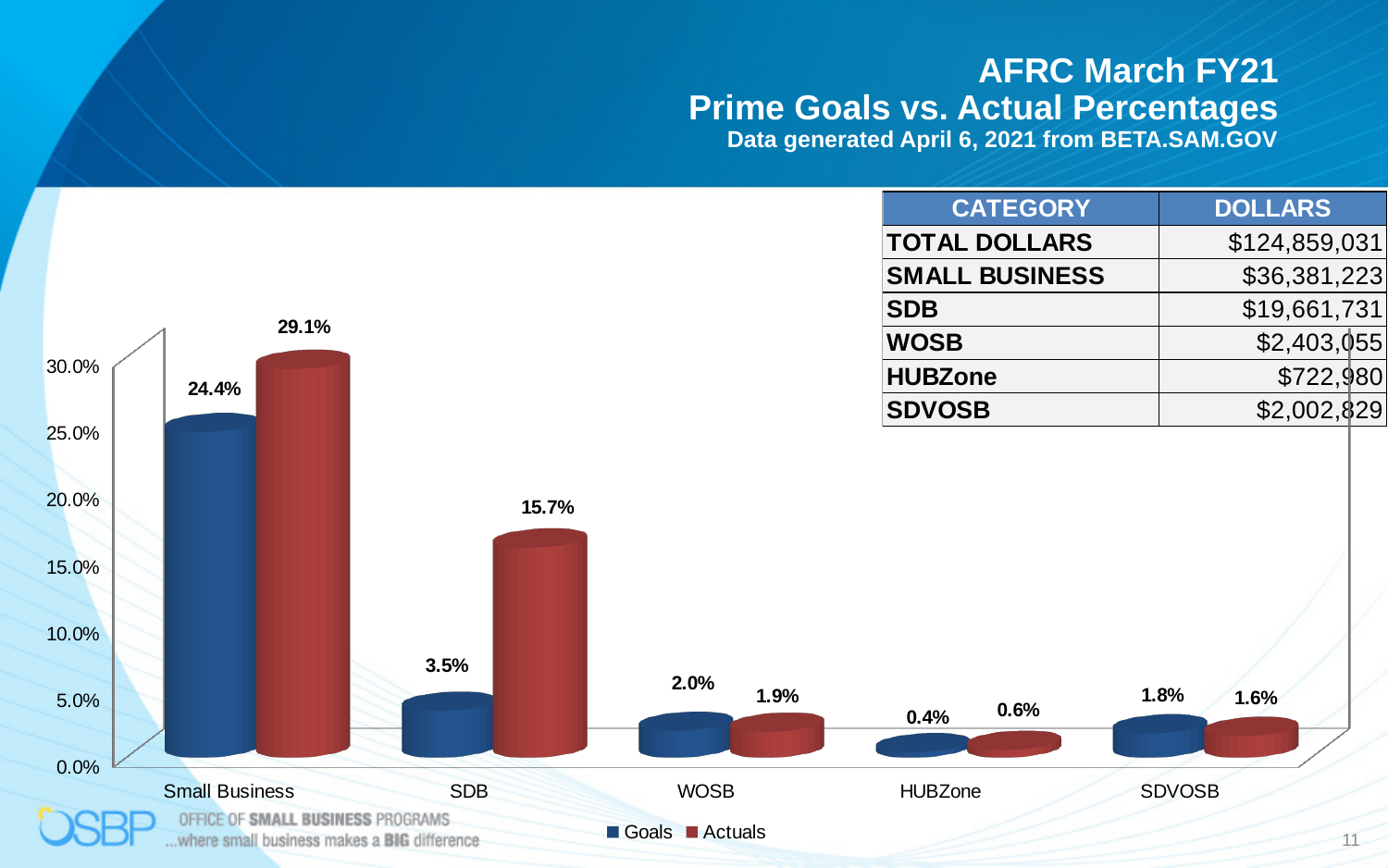
What is the Goals value for SDVOSB? 1.8% Which is larger for WOSB, the Goals value or the Actuals value? Goals What is the Goals value for SDB? 3.5% Which category has the highest Actuals value? Small Business How many categories are shown on the x axis? 5 Is the Actuals value for Small Business greater or less than 25.0%? greater How many series does the legend list? 2 Which category has the lowest Goals value? HUBZone What is the Actuals value for Small Business? 29.1% What is the difference between the Actuals and Goals values for SDB? 12.2% What kind of chart is shown on the slide? Bar chart What is the Actuals value for HUBZone? 0.6%